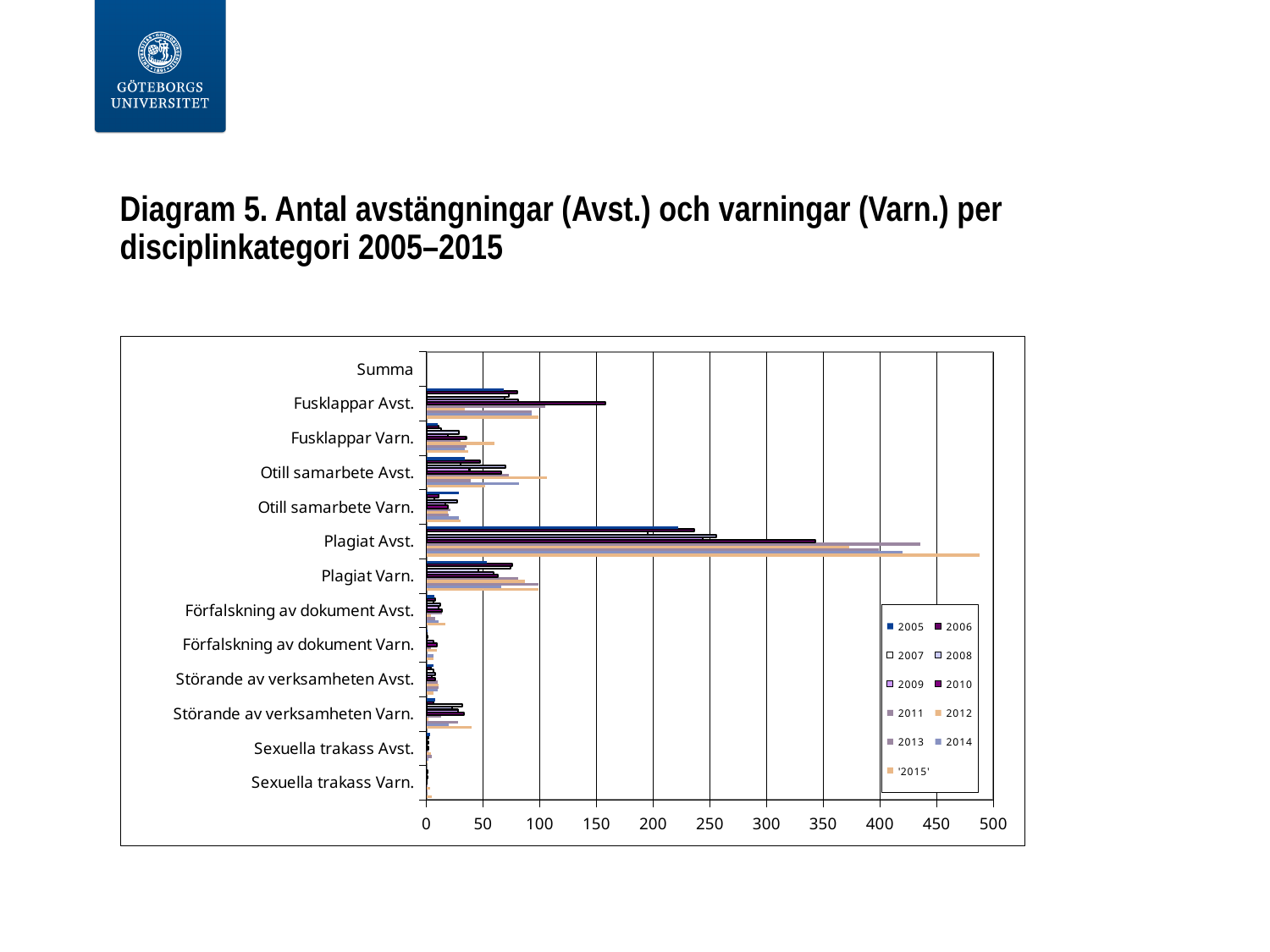
Is the value for Fusklappar Avst. in 2010 greater or less than 100? greater What is the maximum value shown on the horizontal axis of the chart? 500 Which category has the longest bars in the chart? Plagiat Avst. What kind of chart is shown on the slide? bar chart Which category has the shortest bars in the chart? Sexuella trakass Varn. How many categories are listed on the vertical axis of the chart? 13 Is the value for Otill samarbete Avst. in '2015' greater or less than 150? less Is the value for Plagiat Avst. in 2005 greater or less than 200? greater How many series does the legend list? 11 Which is larger: the value for Fusklappar Avst. in 2010 or Fusklappar Varn. in 2010? Fusklappar Avst. Which is larger: the value for Plagiat Avst. in '2015' or in 2005? '2015'